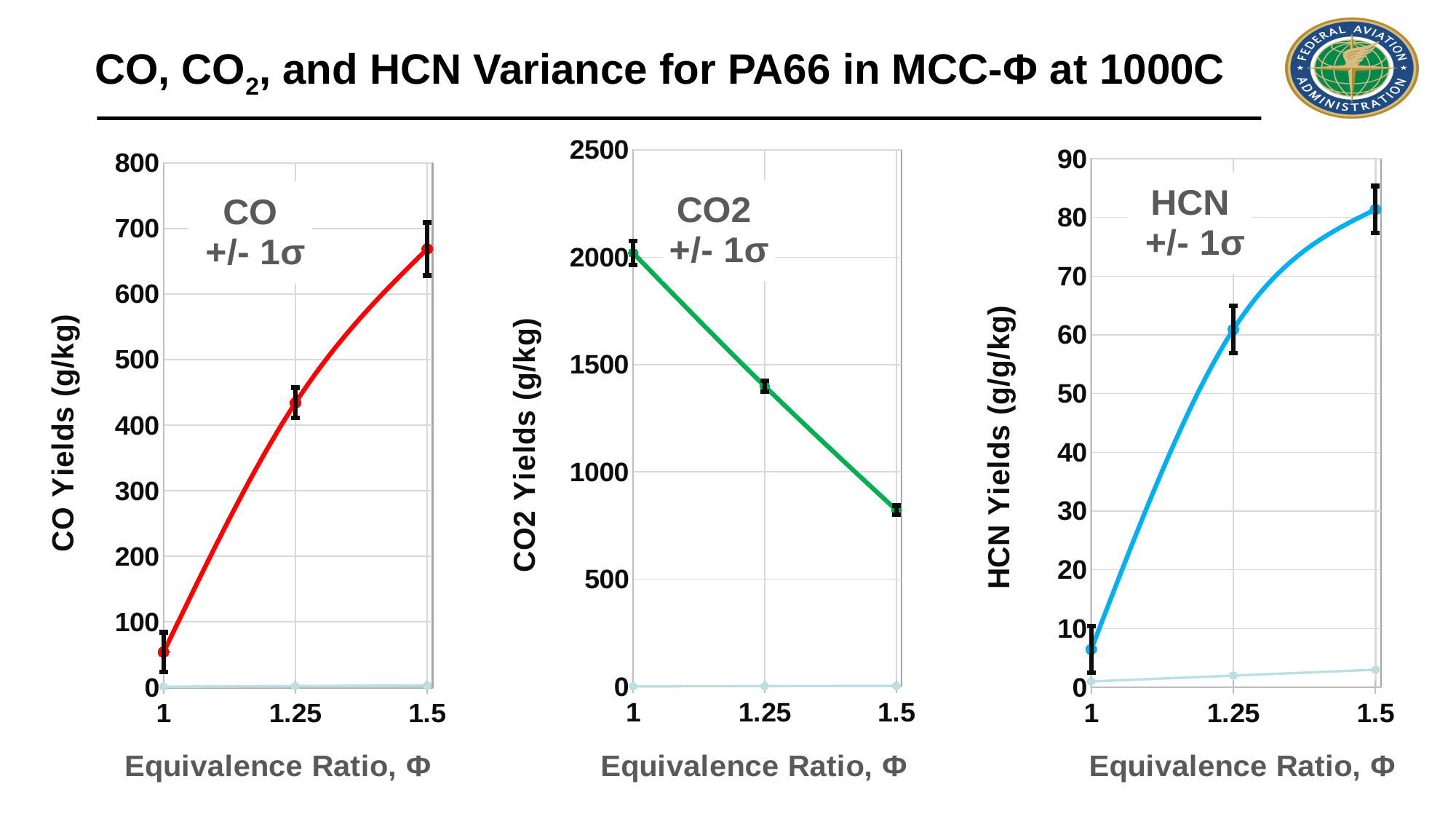
In the HCN chart, at which equivalence ratio is the HCN yield lowest? 1 What is the y-axis label of the HCN chart on the right? HCN Yields (g/g/kg) In the HCN chart, is the HCN yield at equivalence ratio 1.5 greater or less than 70? greater In the CO2 chart, at which equivalence ratio is the CO2 yield highest? 1 How many equivalence ratio values are plotted on the x axis of the CO chart? 3 In the CO chart, is the CO yield at equivalence ratio 1.25 greater or less than 400? greater In the HCN chart, do HCN yields rise or fall as the equivalence ratio increases from 1 to 1.5? rise In the CO chart, is the CO yield at equivalence ratio 1.5 greater or less than 700? less In the CO2 chart, do CO2 yields rise or fall as the equivalence ratio increases from 1 to 1.5? fall What kind of chart is the CO chart on the left? line chart In the CO chart, do CO yields rise or fall as the equivalence ratio increases from 1 to 1.5? rise